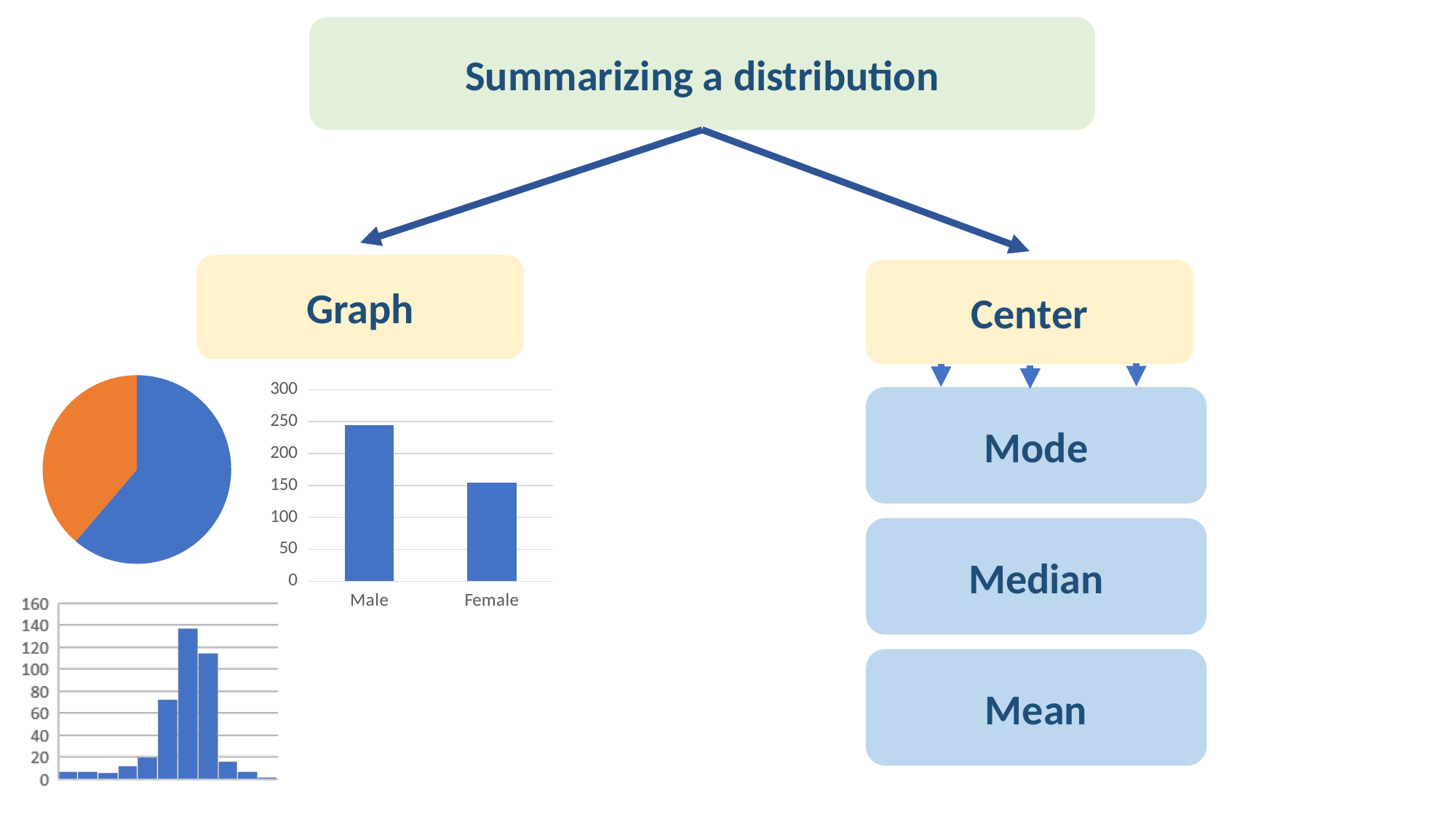
What is the highest tick value on the vertical axis of the bar chart with Male and Female? 300 In the chart at the bottom left of the slide, is the tallest bar greater or less than 120? greater How many categories are shown on the x axis of the bar chart with Male and Female? 2 In the bar chart with Male and Female, is the value for Female greater or less than 200? less In the bar chart with Male and Female, which category has the higher value? Male In the pie chart, which slice is larger, the blue one or the orange one? blue In the bar chart with Male and Female, which category has the lower value? Female How many slices does the pie chart have? 2 In the bar chart with Male and Female, is the value for Male greater or less than 200? greater What kind of chart is the chart at the top left of the slide? pie chart What kind of chart is the chart with Male and Female categories? bar chart